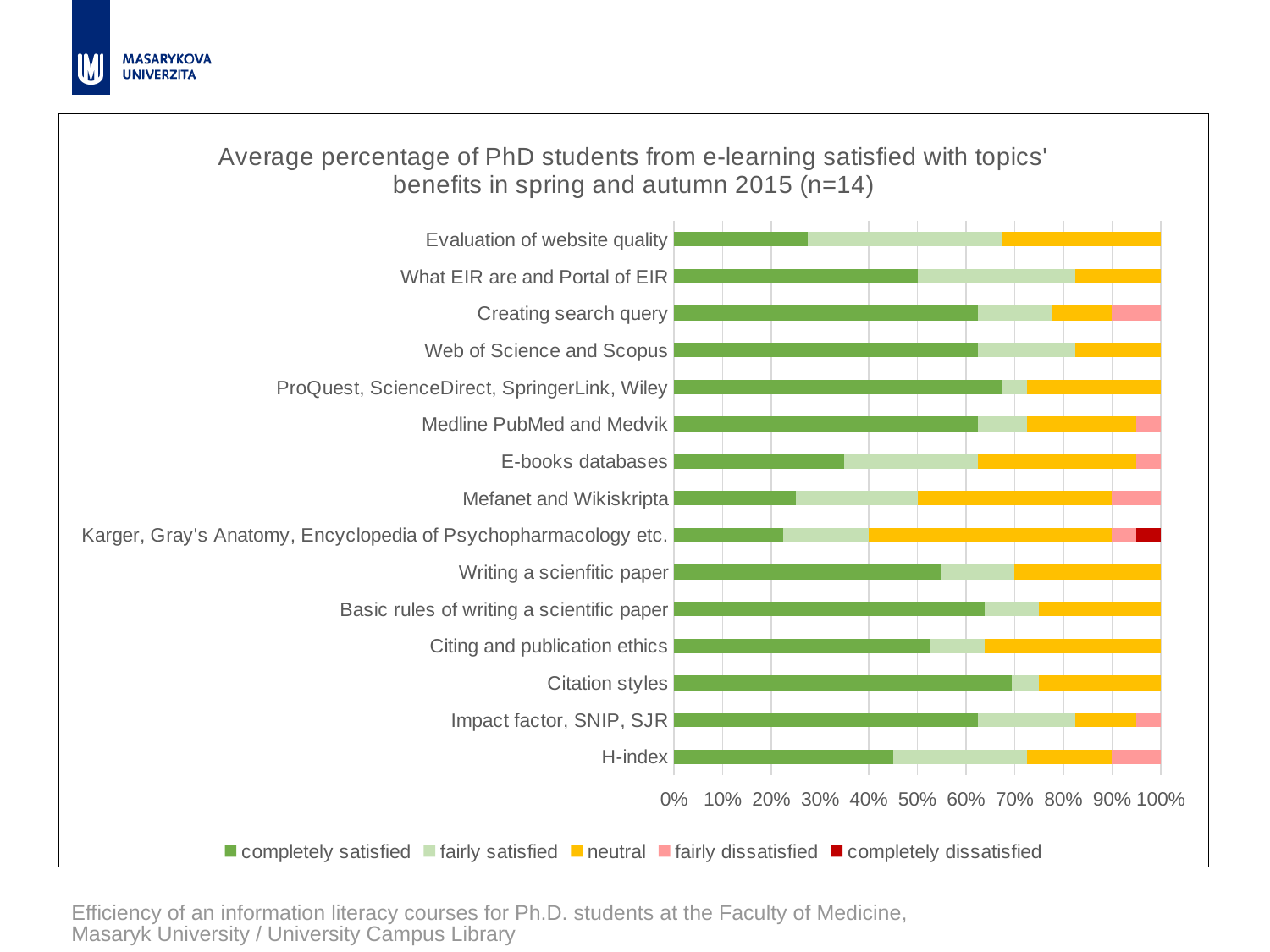
What kind of chart is shown on the slide? Stacked bar chart Which has a larger 'completely satisfied' share: 'Web of Science and Scopus' or 'Mefanet and Wikiskripta'? Web of Science and Scopus What is the sample size (n) stated in the chart title? n=14 Is the 'completely satisfied' share for 'Evaluation of website quality' greater or less than 30%? less How many series does the chart legend list? 5 Which topic is the only one with a 'completely dissatisfied' segment? Karger, Gray's Anatomy, Encyclopedia of Psychopharmacology etc. How many topics (categories) are listed on the vertical axis of the chart? 15 Is the 'completely satisfied' share for 'H-index' greater or less than 50%? less Is the 'completely satisfied' share for 'Citation styles' greater or less than 60%? greater Which has a larger 'completely satisfied' share: 'Citation styles' or 'Evaluation of website quality'? Citation styles